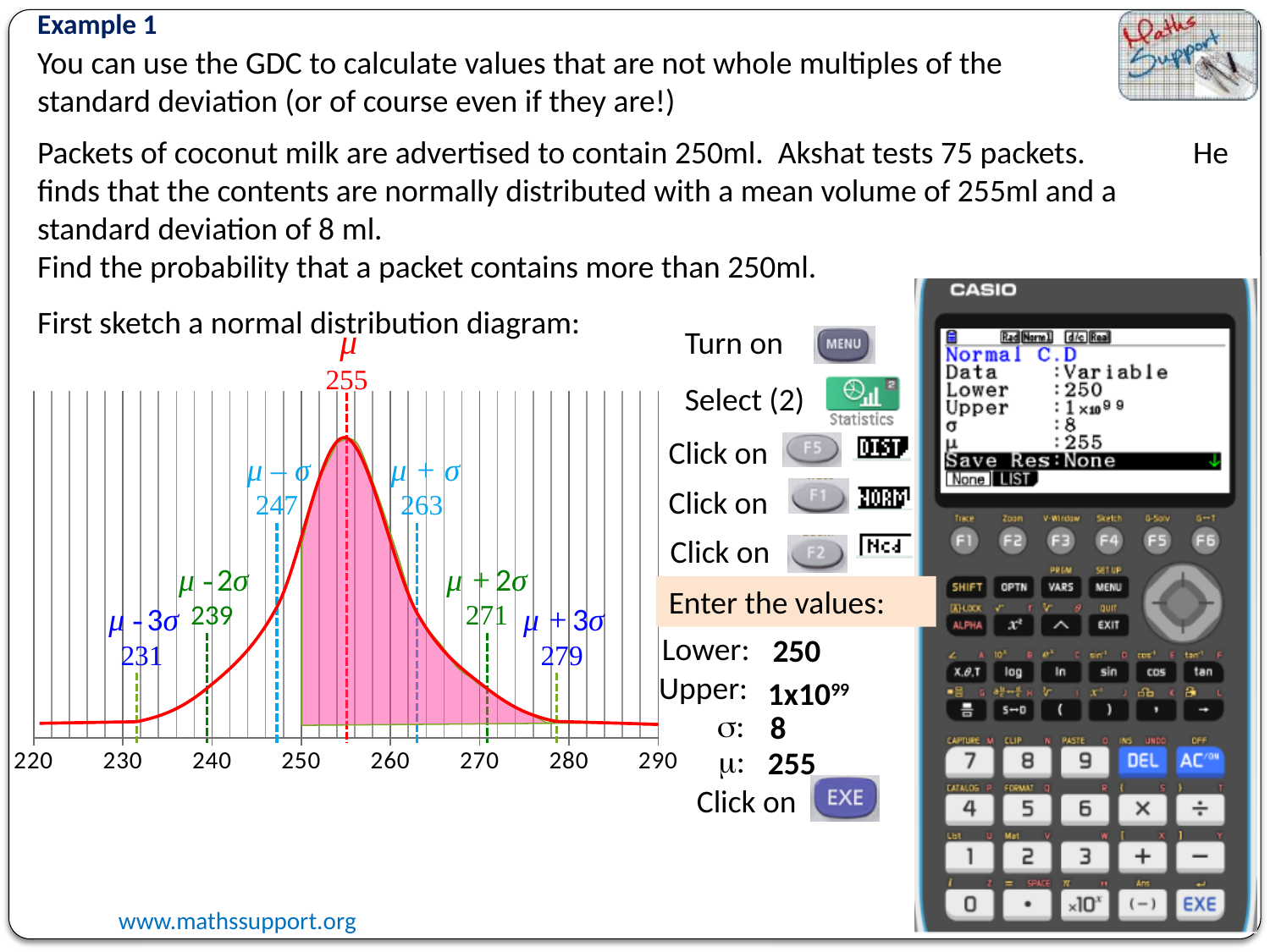
On the normal distribution diagram, what is the difference between the values labelled at μ + σ and μ - σ? 16 What is the largest value shown on the x axis of the normal distribution diagram? 290 On the normal distribution diagram, what value is labelled at the mean μ? 255 On the normal distribution diagram, what is the difference between the values labelled at μ + 3σ and μ? 24 On the normal distribution diagram, which is larger: the value labelled at μ + 2σ or the value labelled at μ - 2σ? μ + 2σ (271) On the normal distribution diagram, what value is labelled at μ - 3σ? 231 How many labelled vertical dashed lines (μ, μ ± σ, μ ± 2σ, μ ± 3σ) are marked on the normal distribution diagram? 7 At what x value does the pink shaded region under the curve begin? 250 Does the curve on the normal distribution diagram rise or fall as x increases from 255 to 290? fall On the normal distribution diagram, what value is labelled at μ + σ? 263 On the normal distribution diagram, what value is labelled at μ + 2σ? 271 What is the smallest value shown on the x axis of the normal distribution diagram? 220